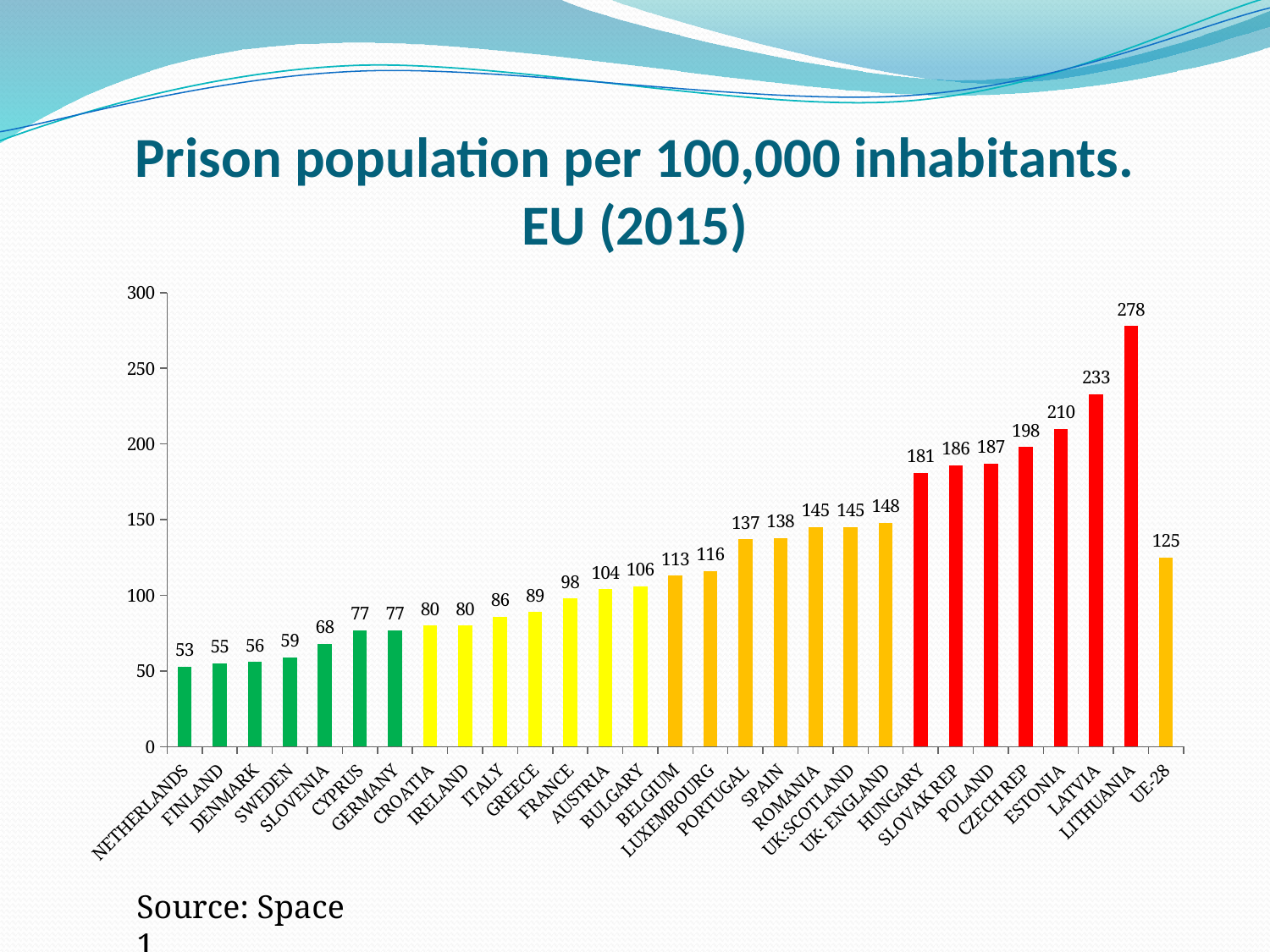
What is the title of the chart on the slide? Prison population per 100,000 inhabitants. EU (2015) Which country has the highest prison population per 100,000 inhabitants? Lithuania Is the value for Czech Rep greater or less than 150? greater Which has a higher value, Hungary or UK: England? Hungary What is the prison population per 100,000 inhabitants for Lithuania? 278 What kind of chart is shown on the slide? Bar chart What is the difference between the values for Latvia and Estonia? 23 What is the value shown for UE-28? 125 Which country has the lowest prison population per 100,000 inhabitants? Netherlands What is the value shown for Poland? 187 How many bars are shown in the chart? 29 What is the value shown for the Netherlands? 53